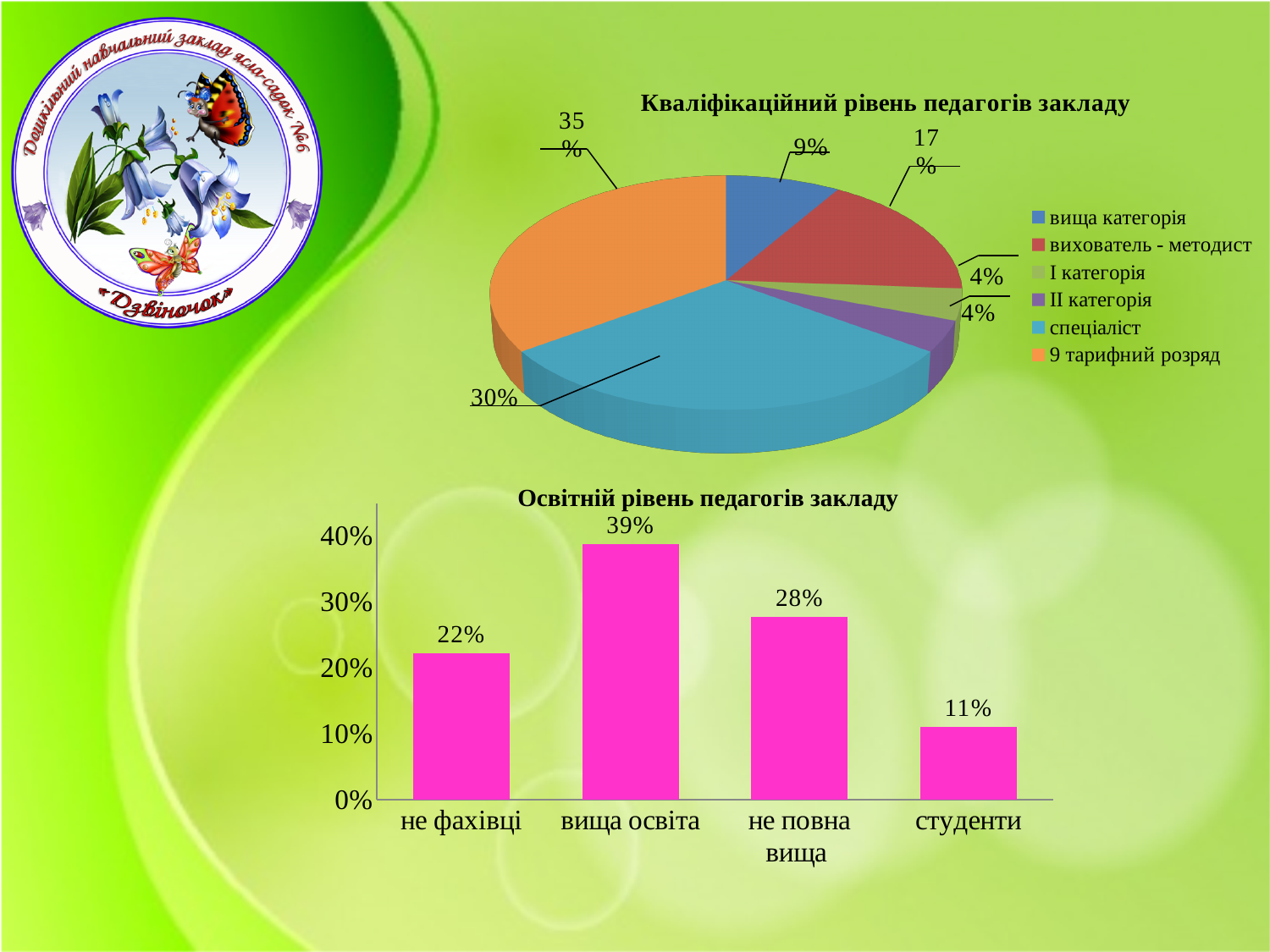
What kind of chart is 'Освітній рівень педагогів закладу'? bar chart On the bar chart 'Освітній рівень педагогів закладу', which is larger: 'не фахівці' or 'не повна вища'? не повна вища On the bar chart 'Освітній рівень педагогів закладу', what is the difference between 'вища освіта' and 'не повна вища'? 11% On the bar chart 'Освітній рівень педагогів закладу', what is the value for 'студенти'? 11% On the pie chart 'Кваліфікаційний рівень педагогів закладу', what share does 'спеціаліст' have? 30% What kind of chart is 'Кваліфікаційний рівень педагогів закладу'? pie chart How many categories are shown on the bar chart 'Освітній рівень педагогів закладу'? 4 On the bar chart 'Освітній рівень педагогів закладу', which category has the lowest value? студенти How many entries does the legend of the pie chart 'Кваліфікаційний рівень педагогів закладу' list? 6 On the pie chart 'Кваліфікаційний рівень педагогів закладу', what share does 'вихователь - методист' have? 17% On the bar chart 'Освітній рівень педагогів закладу', what is the value for 'вища освіта'? 39% On the bar chart 'Освітній рівень педагогів закладу', which category has the highest value? вища освіта